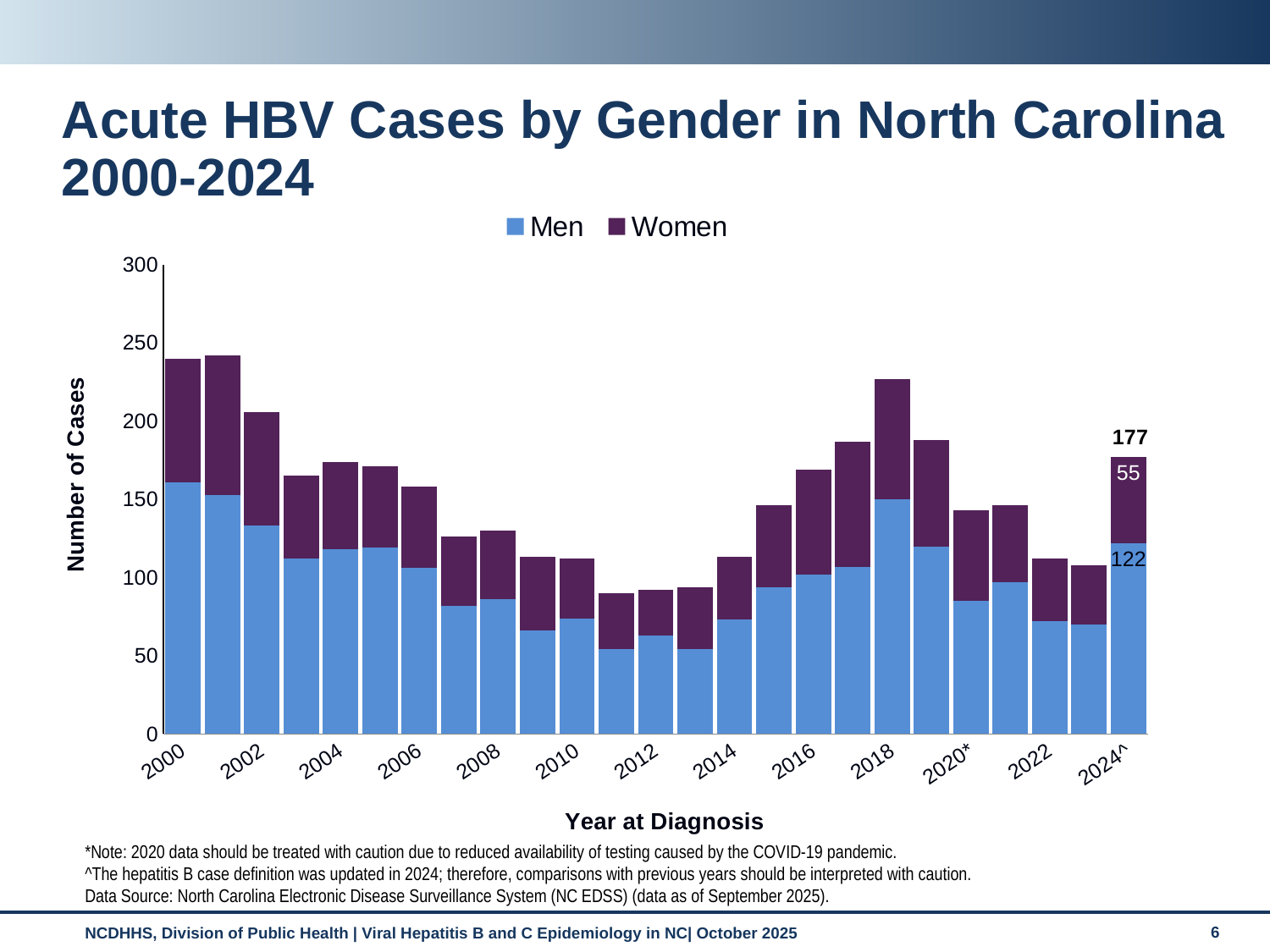
What is the total number of acute HBV cases shown for 2024? 177 Do total acute HBV cases generally rise or fall from 2013 to 2018? rise How many series does the legend list? 2 Is the total number of cases in 2011 greater or less than 100? less What is the number of acute HBV cases among women in 2024? 55 Which year has the larger total number of cases, 2018 or 2019? 2018 In 2024, how many more cases were among men than among women? 67 Is the total number of cases in 2018 greater or less than 200? greater What is the number of acute HBV cases among men in 2024? 122 What kind of chart is shown on the slide? Stacked bar chart How many years (bars) are plotted on the chart? 25 Which colour represents Women in the chart? Purple